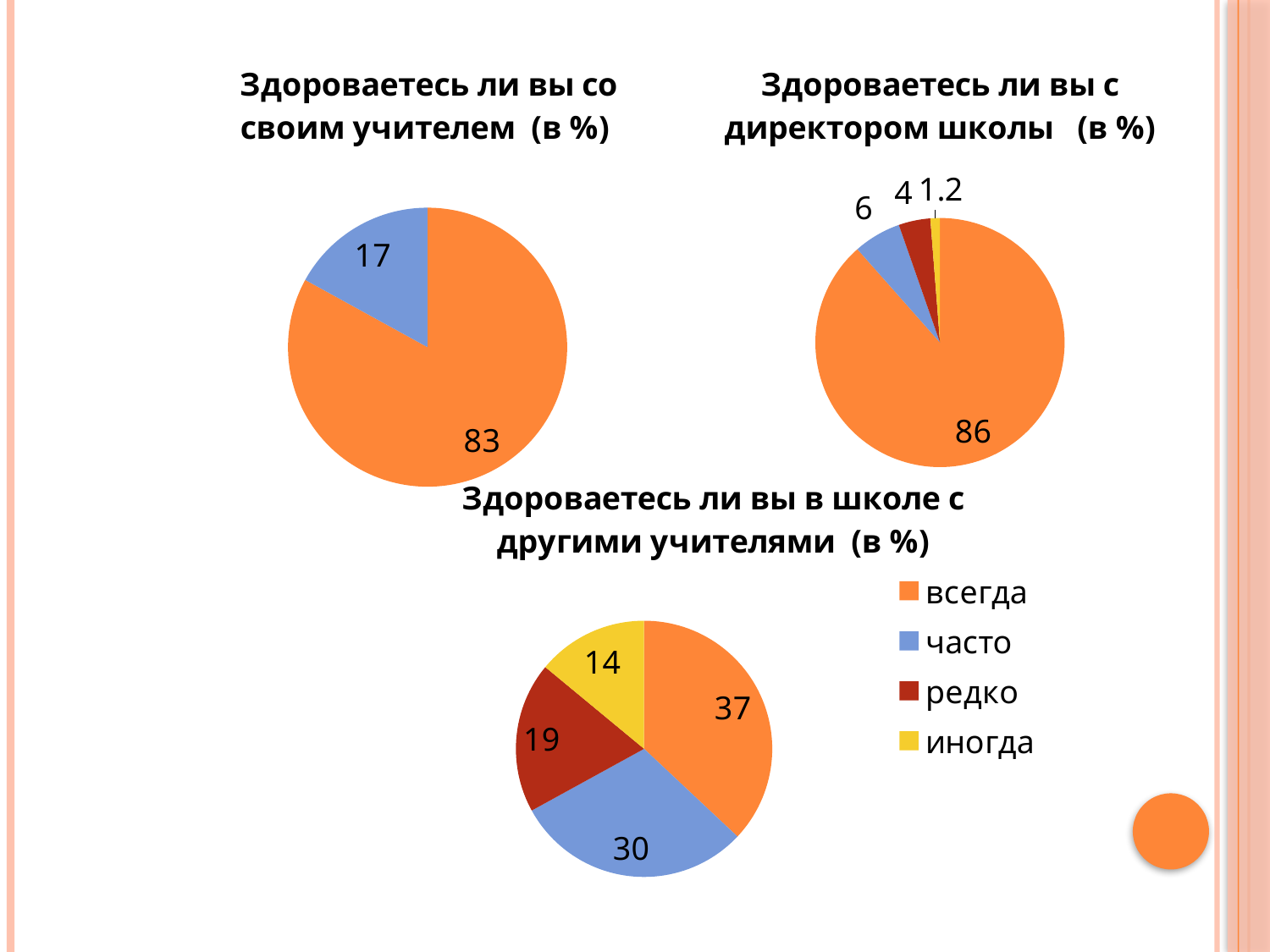
How many entries does the legend on the slide list? 4 How many slices does the chart 'Здороваетесь ли вы со своим учителем (в %)' have? 2 In the chart 'Здороваетесь ли вы в школе с другими учителями (в %)', what is the value for 'редко'? 19 What type of chart is 'Здороваетесь ли вы с директором школы (в %)'? Pie chart In the chart 'Здороваетесь ли вы в школе с другими учителями (в %)', what is the difference between 'всегда' and 'часто'? 7 In the chart 'Здороваетесь ли вы в школе с другими учителями (в %)', which is larger, 'редко' or 'иногда'? редко In the chart 'Здороваетесь ли вы в школе с другими учителями (в %)', which category has the largest slice? всегда In the chart 'Здороваетесь ли вы со своим учителем (в %)', what is the value for 'часто'? 17 In the chart 'Здороваетесь ли вы со своим учителем (в %)', what is the value for 'всегда'? 83 In the chart 'Здороваетесь ли вы с директором школы (в %)', what is the value for 'всегда'? 86